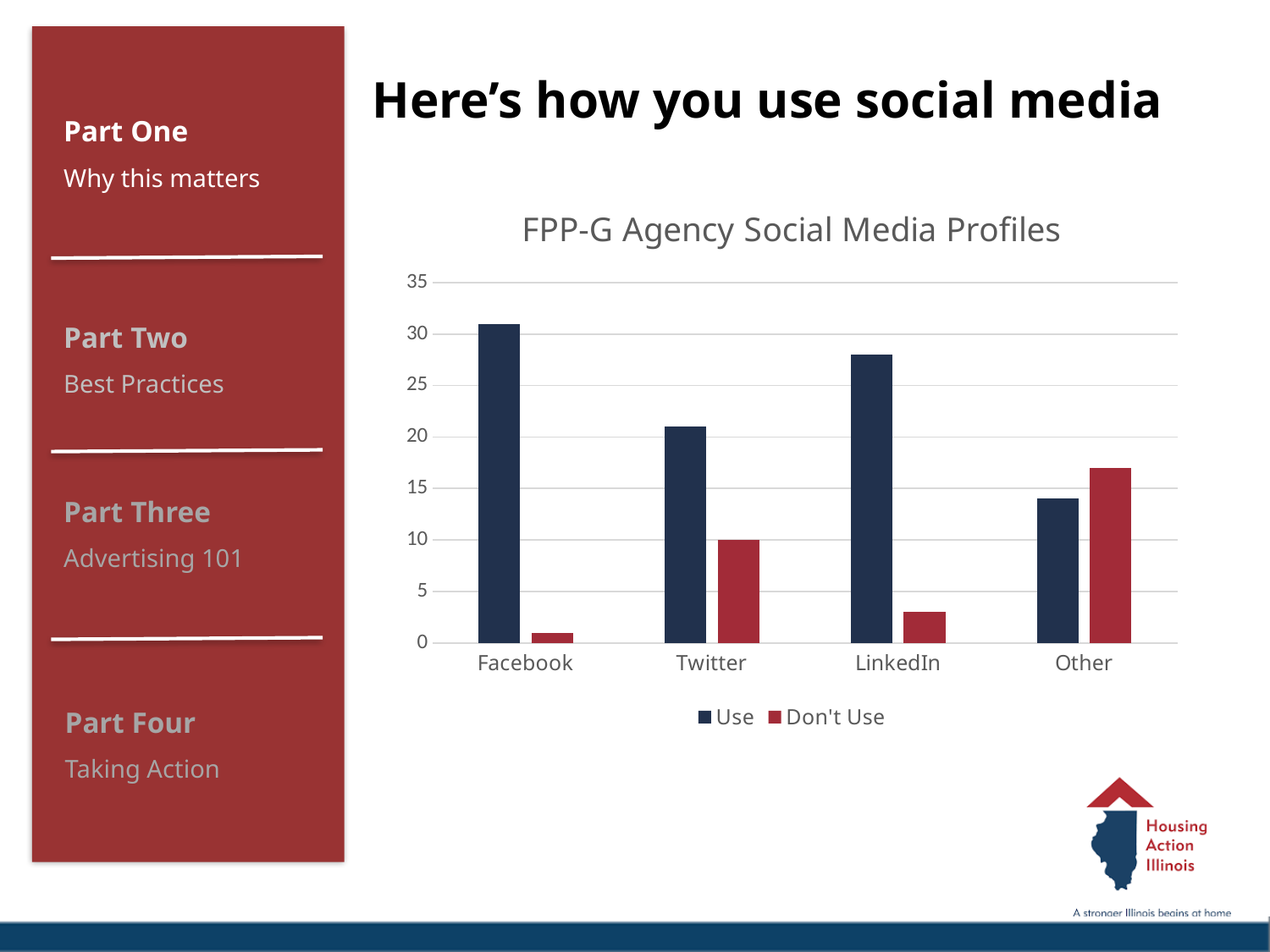
For the Other category, which is larger, Use or Don't Use? Don't Use Which series is shown in dark blue? Use How many series does the legend list? 2 Which category has the highest value for the Use series? Facebook Which category has the lowest value for the Don't Use series? Facebook What kind of chart is shown on the slide? bar chart Is the Use value for Facebook greater or less than 30? greater What is the title of the chart? FPP-G Agency Social Media Profiles Is the Don't Use value for LinkedIn greater or less than 5? less How many categories are shown on the x axis? 4 Which category has the highest value for the Don't Use series? Other Is the Use value for Twitter greater or less than 25? less